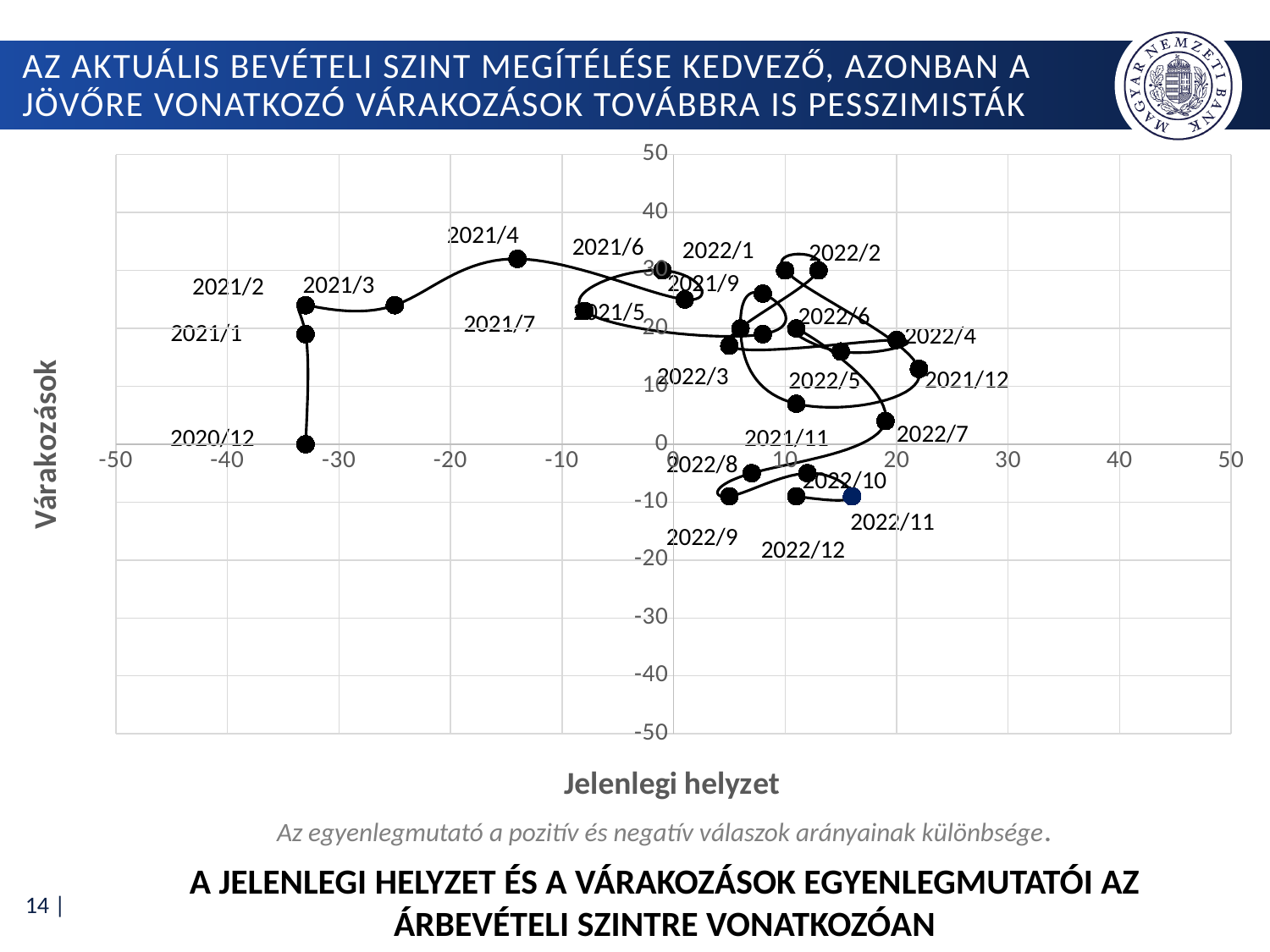
Is the vertical-axis value (Várakozások) for 2022/9 greater or less than 0? less Is the vertical-axis value (Várakozások) for 2021/4 greater or less than 20? greater Is the horizontal-axis value (Jelenlegi helyzet) for 2021/1 greater or less than -30? less Which point has the higher horizontal-axis value (Jelenlegi helyzet): 2022/11 or 2021/1? 2022/11 What is the title of the horizontal axis of the chart? Jelenlegi helyzet What kind of chart is shown on the slide? scatter chart Which point has the higher vertical-axis value (Várakozások): 2021/4 or 2020/12? 2021/4 What is the title of the vertical axis of the chart? Várakozások